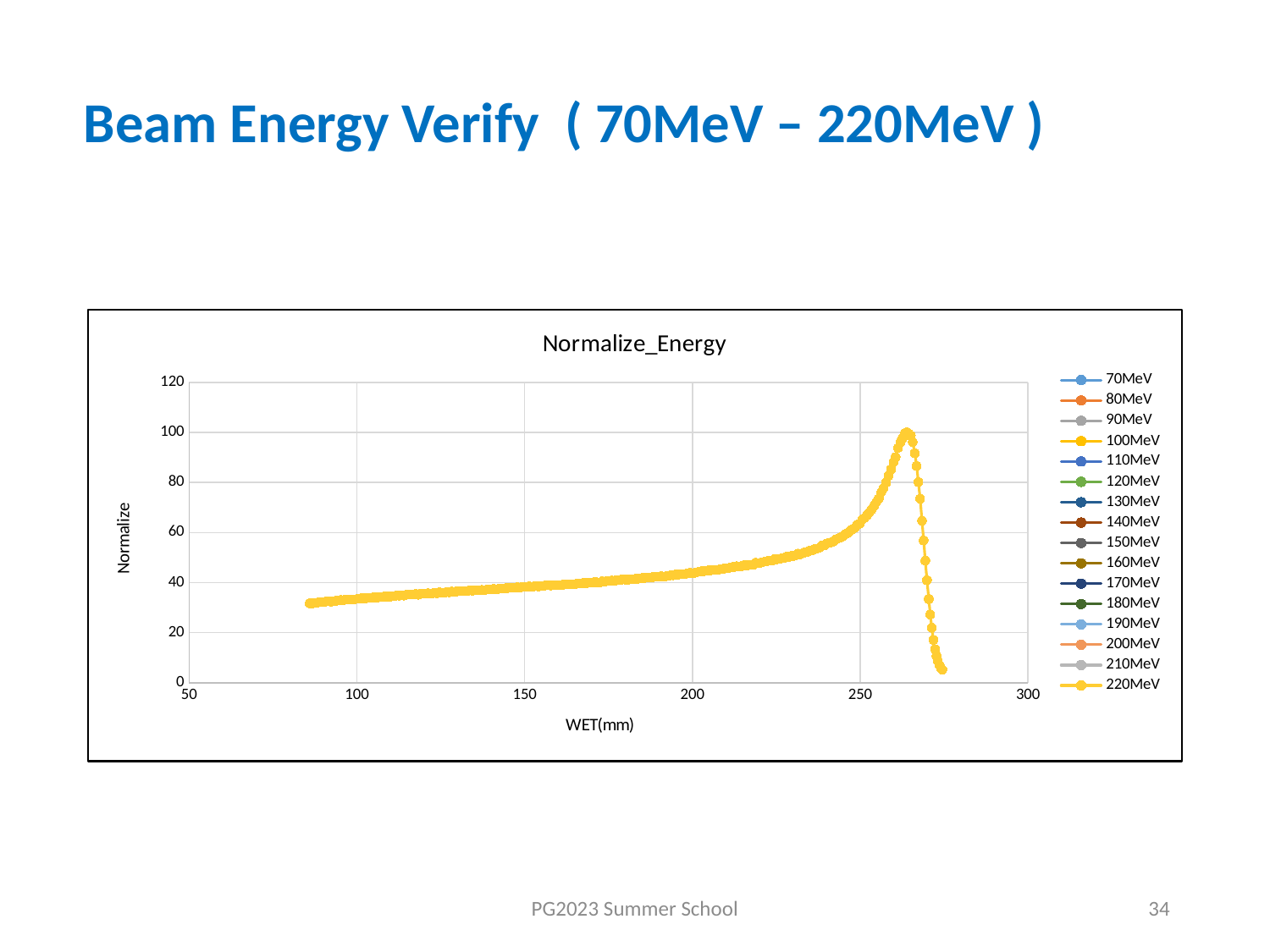
After reaching its peak near WET 260 mm, does the plotted curve rise or fall? It falls What kind of chart is shown on the slide? Line chart Is the value of the plotted curve at WET 150 mm greater or less than 20? greater Is the value of the plotted curve at WET 200 mm greater or less than 60? less Is the value of the plotted curve at WET 250 mm greater or less than 40? greater What is the title of the chart? Normalize_Energy How many series does the chart legend list? 16 Which of the two is larger: the value of the plotted curve at WET 250 mm or at WET 100 mm? WET 250 mm How does the plotted curve behave as WET increases from 100 mm to about 260 mm? It rises What is the label of the x axis? WET(mm)